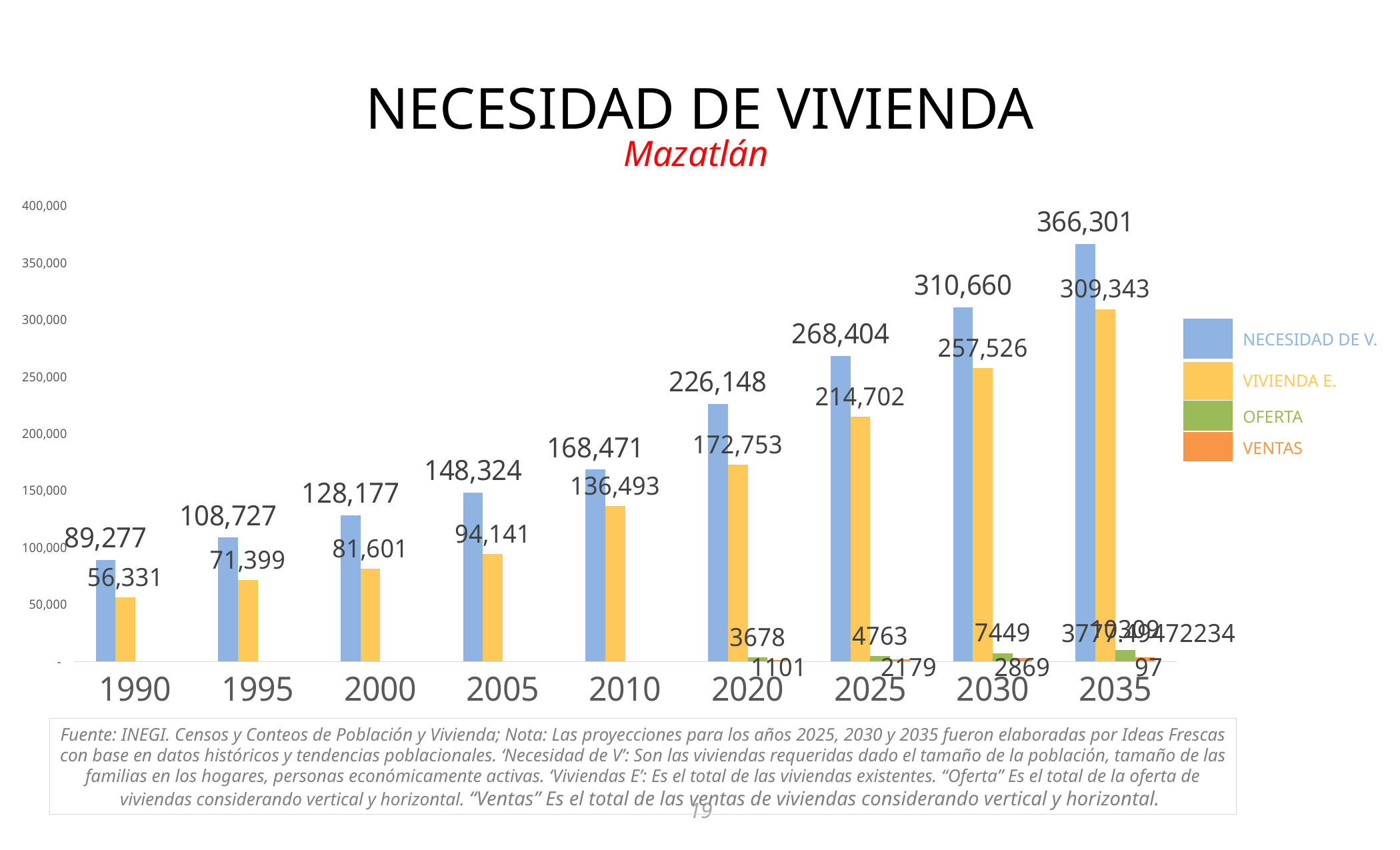
What is the difference between NECESIDAD DE V. and VIVIENDA E. in 2035? 56,958 Do the NECESIDAD DE V. values rise or fall from 1990 to 2035? Rise What kind of chart is shown on the slide? Bar chart How many years are shown on the x axis? 9 In 2020, which is larger: NECESIDAD DE V. or VIVIENDA E.? NECESIDAD DE V. What is the OFERTA value for 2030? 7449 How many series does the legend list? 4 What is the value of NECESIDAD DE V. for 2010? 168,471 Which series is shown in green in the legend? OFERTA Which year has the highest NECESIDAD DE V. value? 2035 Which year has the lowest VIVIENDA E. value? 1990 What is the value of VIVIENDA E. for 2025? 214,702